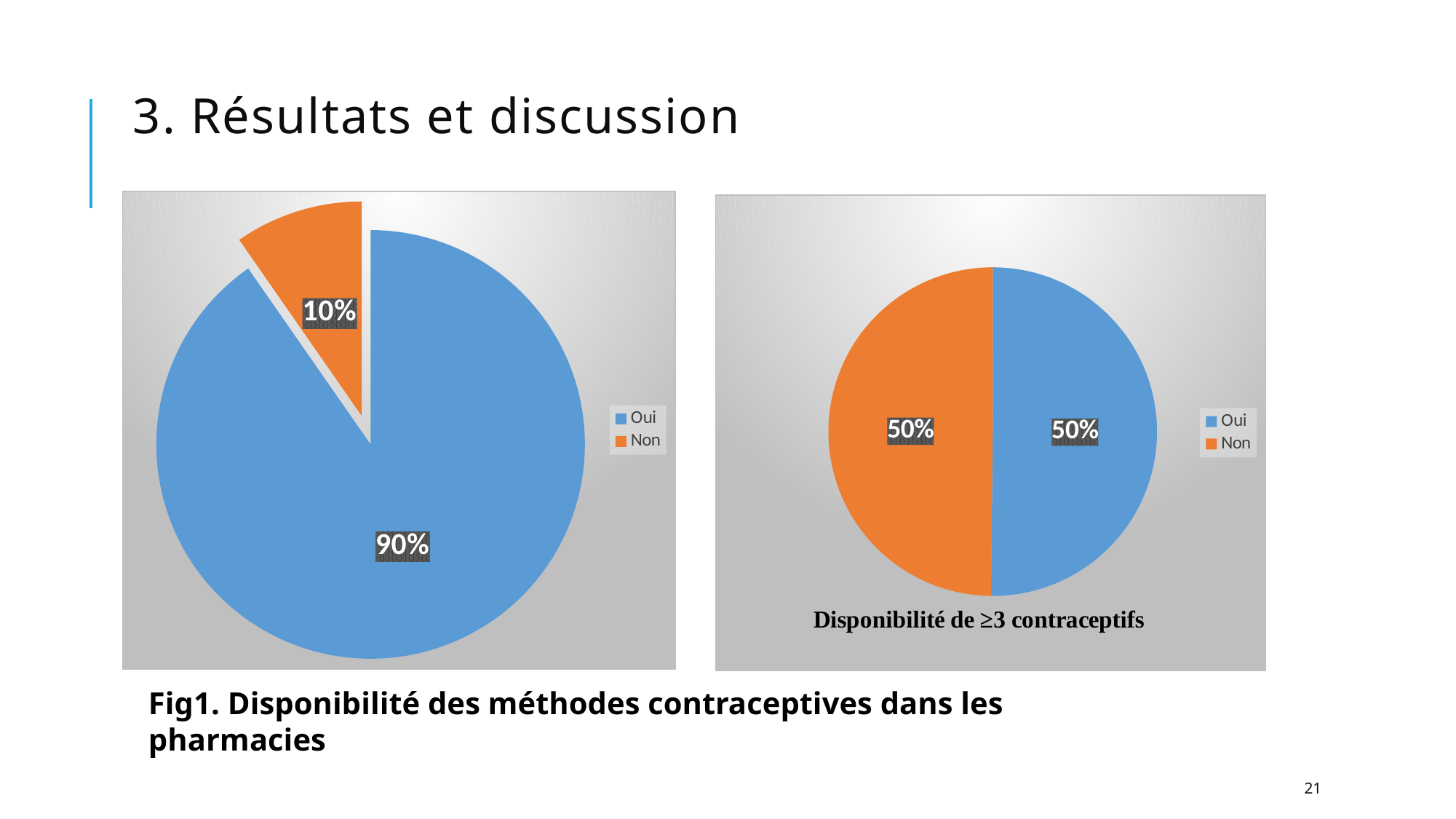
In the left pie chart, which category has the largest slice? Oui In the left pie chart, what share does the Non slice have? 10% In the left pie chart, which category has the smallest slice? Non In the right pie chart titled 'Disponibilité de ≥3 contraceptifs', what share does the Oui slice have? 50% How many entries does the legend of the right pie chart list? 2 What colour is the Non slice in the left pie chart? Orange In the left pie chart, what is the difference in percentage points between the Oui and Non slices? 80 In the left pie chart, what share does the Oui slice have? 90% In the left pie chart, which slice is larger, Oui or Non? Oui How many slices does the left pie chart have? 2 What type of chart is shown on the right side of the slide? Pie chart In the right pie chart titled 'Disponibilité de ≥3 contraceptifs', what share does the Non slice have? 50%